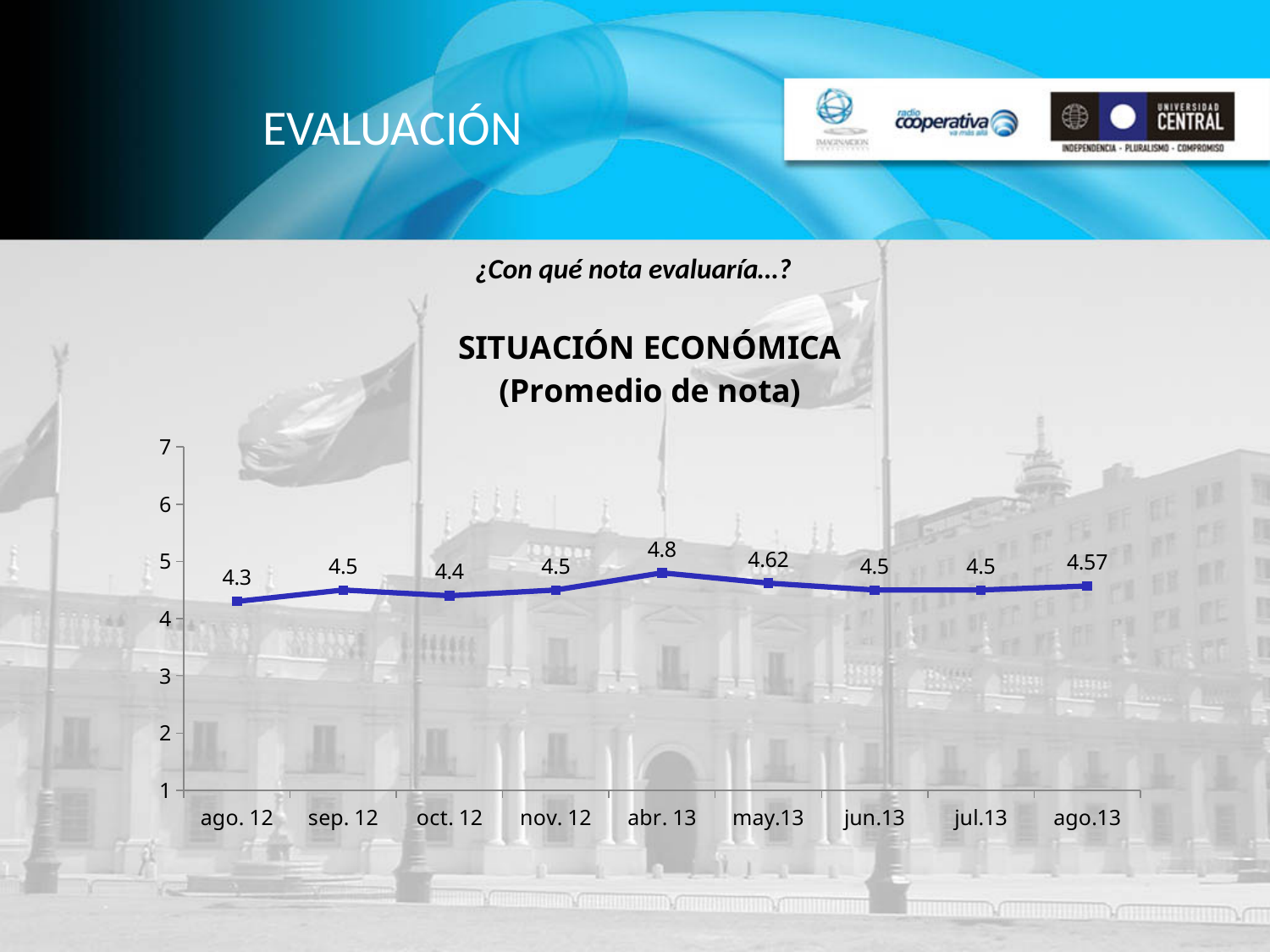
Which month has the lowest value? ago. 12 What kind of chart is shown? line chart Which month has the highest value? abr. 13 Which is larger, the value for may.13 or the value for ago.13? may.13 What is the value for abr. 13? 4.8 Is the value for abr. 13 greater or less than 5? less What is the title of the chart? SITUACIÓN ECONÓMICA (Promedio de nota) What is the value for ago.13? 4.57 How many months are plotted on the chart? 9 What is the value for ago. 12? 4.3 What is the difference between the values for abr. 13 and ago. 12? 0.5 What is the value for may.13? 4.62